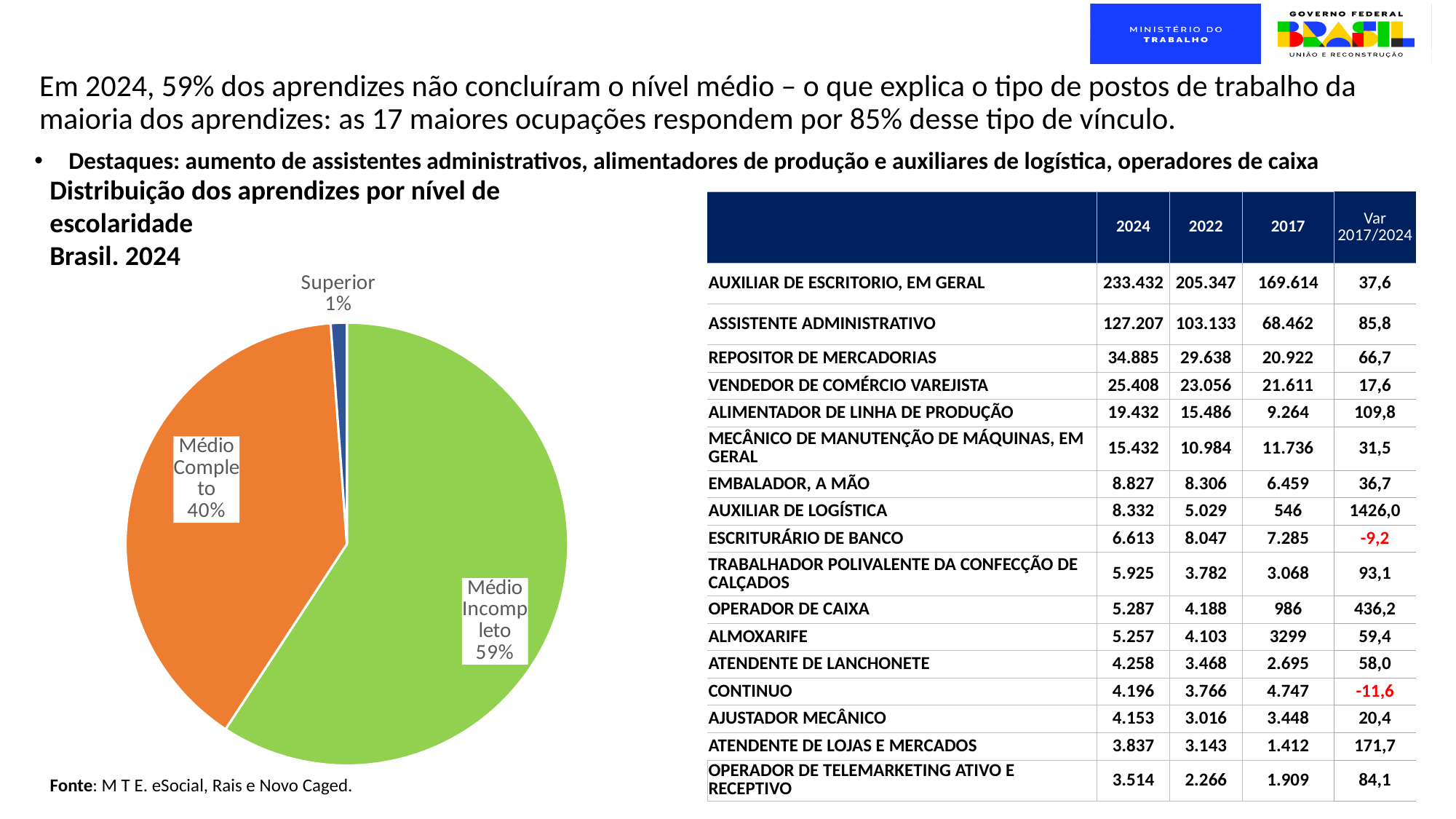
Which category has the largest slice in the pie chart? Médio Incompleto Which category has the smallest slice in the pie chart? Superior What is the difference in percentage points between Médio Incompleto and Médio Completo in the pie chart? 19 What share of the pie chart does Médio Completo represent? 40% What kind of chart is shown on the slide? pie chart What colour is the Médio Completo slice in the pie chart? orange What share of the pie chart does Médio Incompleto represent? 59% What is the title of the pie chart? Distribuição dos aprendizes por nível de escolaridade Brasil. 2024 How many slices does the pie chart have? 3 Which is larger in the pie chart, Médio Completo or Superior? Médio Completo What share of the pie chart does Superior represent? 1% What is the difference in percentage points between Médio Completo and Superior in the pie chart? 39